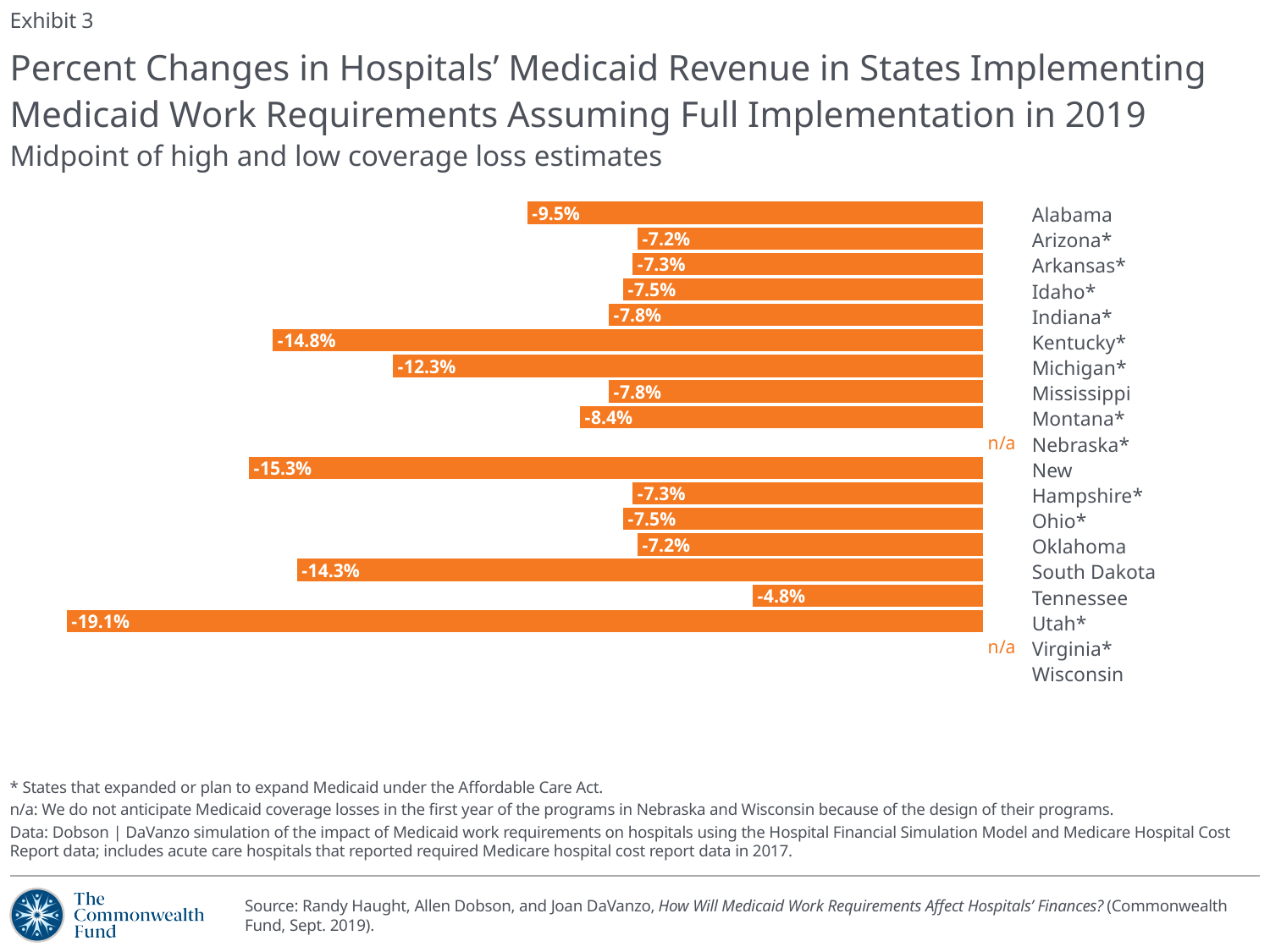
Which state shows a larger decline in Medicaid revenue, Kentucky or Michigan? Kentucky How many states are listed on the chart? 18 Which state shows the largest percent decline in hospitals' Medicaid revenue? Virginia What is the percent change shown for Michigan? -12.3% What does the subtitle say the values represent? Midpoint of high and low coverage loss estimates Among states with a value shown, which state has the smallest percent decline? Utah What is the percent change shown for Kentucky? -14.8% How many percentage points larger is Virginia's decline than New Hampshire's? 3.8 percentage points What is the percent change in hospitals' Medicaid revenue shown for Virginia? -19.1% What is the percent change shown for Utah? -4.8% Which two states are marked n/a on the chart? Nebraska and Wisconsin What kind of chart is shown on the slide? Bar chart